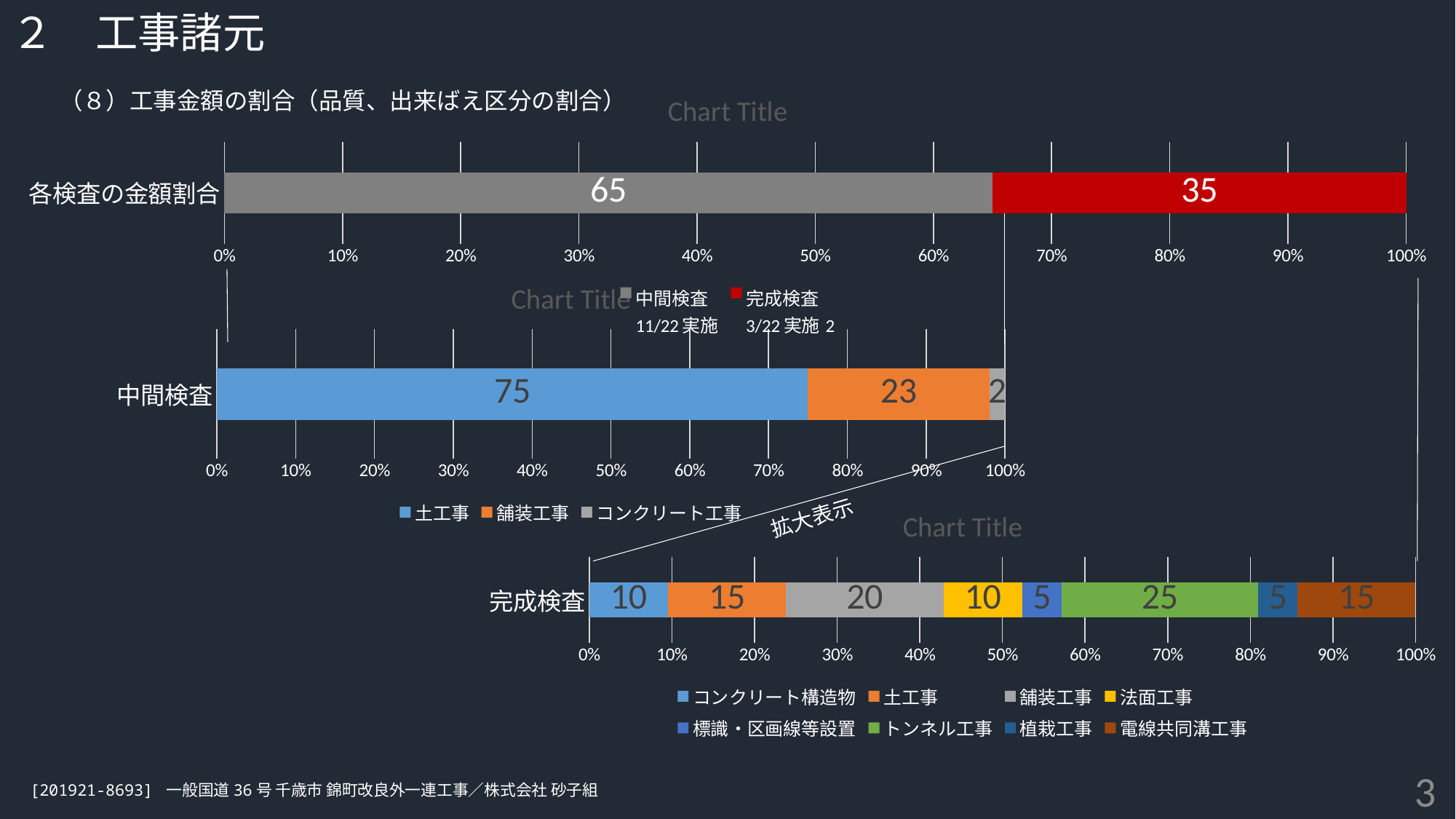
In the middle chart (中間検査), how many series does the legend list? 3 In the bottom chart (完成検査), what is the value for 電線共同溝工事? 15 In the bottom chart (完成検査), which is larger, 舗装工事 or 法面工事? 舗装工事 In the middle chart (中間検査), which series has the smallest value? コンクリート工事 In the middle chart (中間検査), what is the value for 舗装工事? 23 What kind of chart is the bottom chart (完成検査)? Stacked bar chart In the top chart (各検査の金額割合), what is the difference between the 中間検査 and 完成検査 values? 30 In the bottom chart (完成検査), how many series does the legend list? 8 In the top chart (各検査の金額割合), what is the value for 完成検査? 35 In the top chart (各検査の金額割合), what is the value for 中間検査? 65 In the bottom chart (完成検査), what is the value for トンネル工事? 25 In the middle chart (中間検査), which series has the largest value? 土工事